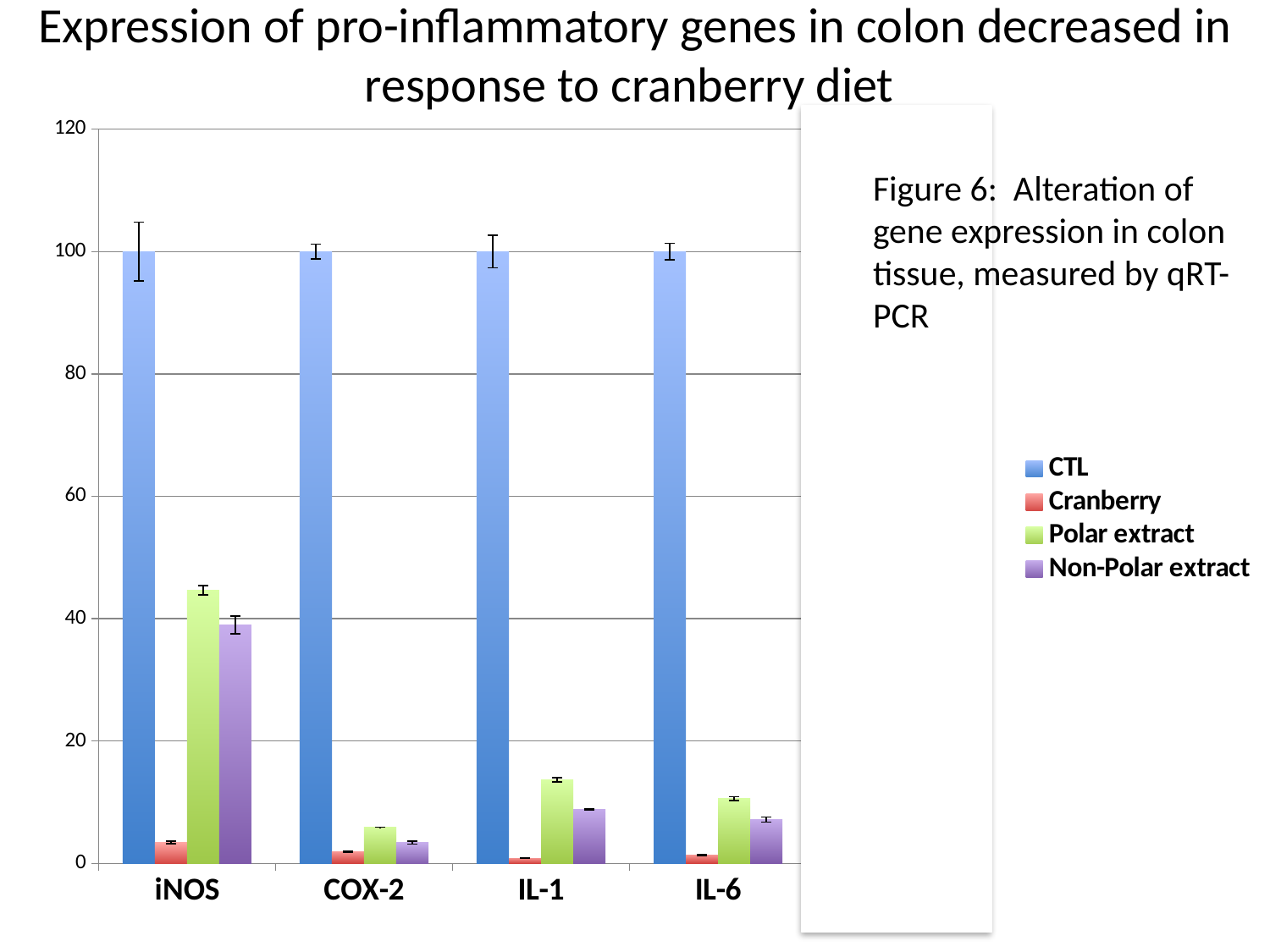
Is the Polar extract value for iNOS greater or less than 40? greater How many series does the legend list? 4 For iNOS, which is larger: the Polar extract value or the Non-Polar extract value? Polar extract Is the Non-Polar extract value for iNOS greater or less than 20? greater Is the Polar extract value for COX-2 greater or less than 20? less What is the CTL value for iNOS? 100 What kind of chart is shown on the slide? bar chart How many gene categories are shown on the x axis? 4 Which colour represents the Cranberry series in the legend? red What is the CTL value for IL-6? 100 Which gene has the highest Polar extract value? iNOS Which series has the lowest value for IL-1? Cranberry